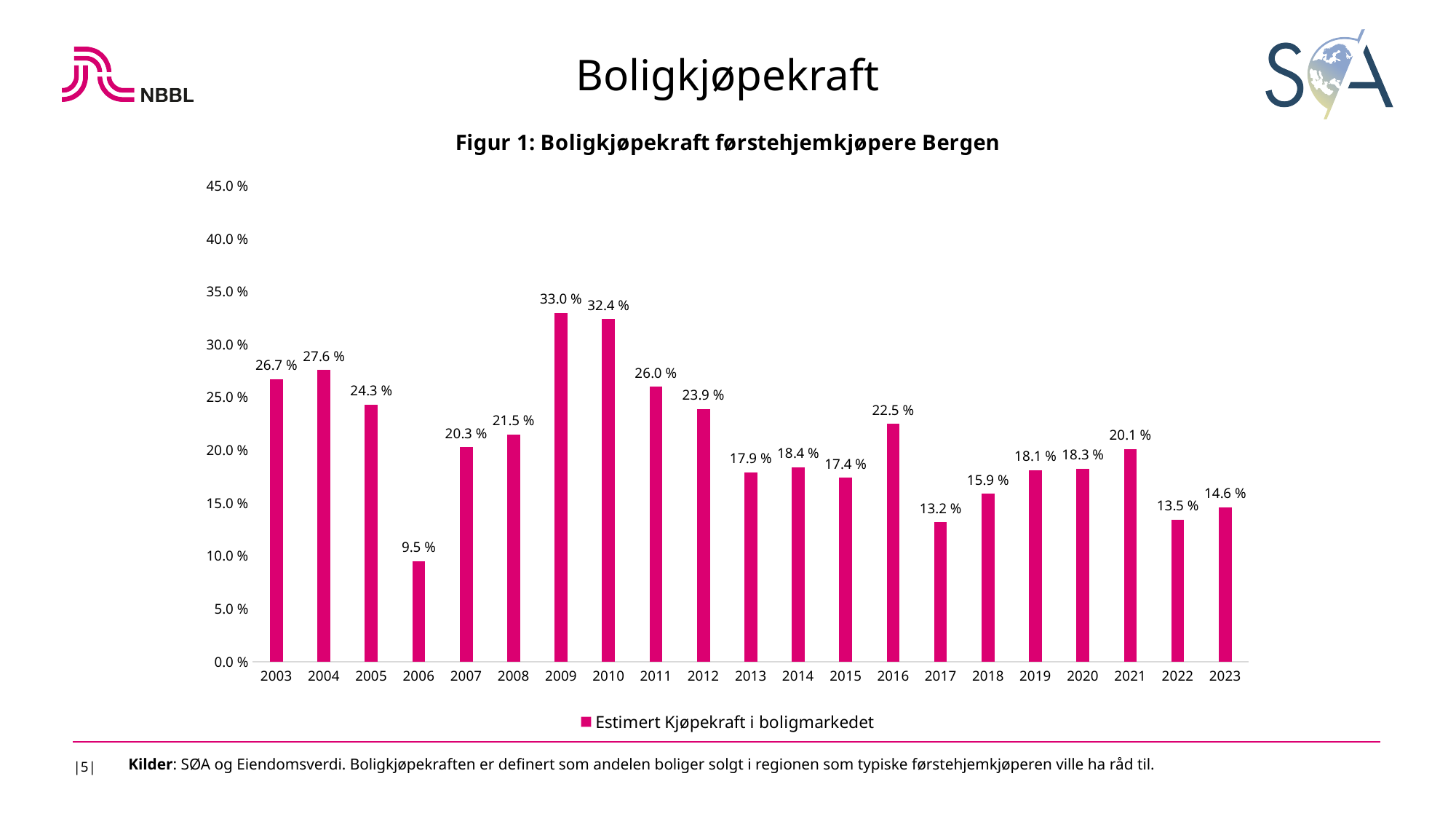
What is the difference between the values for 2004 and 2006? 18.1 % Is the value for 2017 greater or less than 15.0 %? less What is the value for 2009? 33.0 % What is the value for 2023? 14.6 % Which year has the lowest value? 2006 Which year has the highest value? 2009 What is the difference between the values for 2009 and 2010? 0.6 % Which is larger, the value for 2016 or the value for 2021? 2016 What is the legend entry for the series? Estimert Kjøpekraft i boligmarkedet How many years are shown on the x axis? 21 What is the value for 2006? 9.5 % What kind of chart is this? bar chart